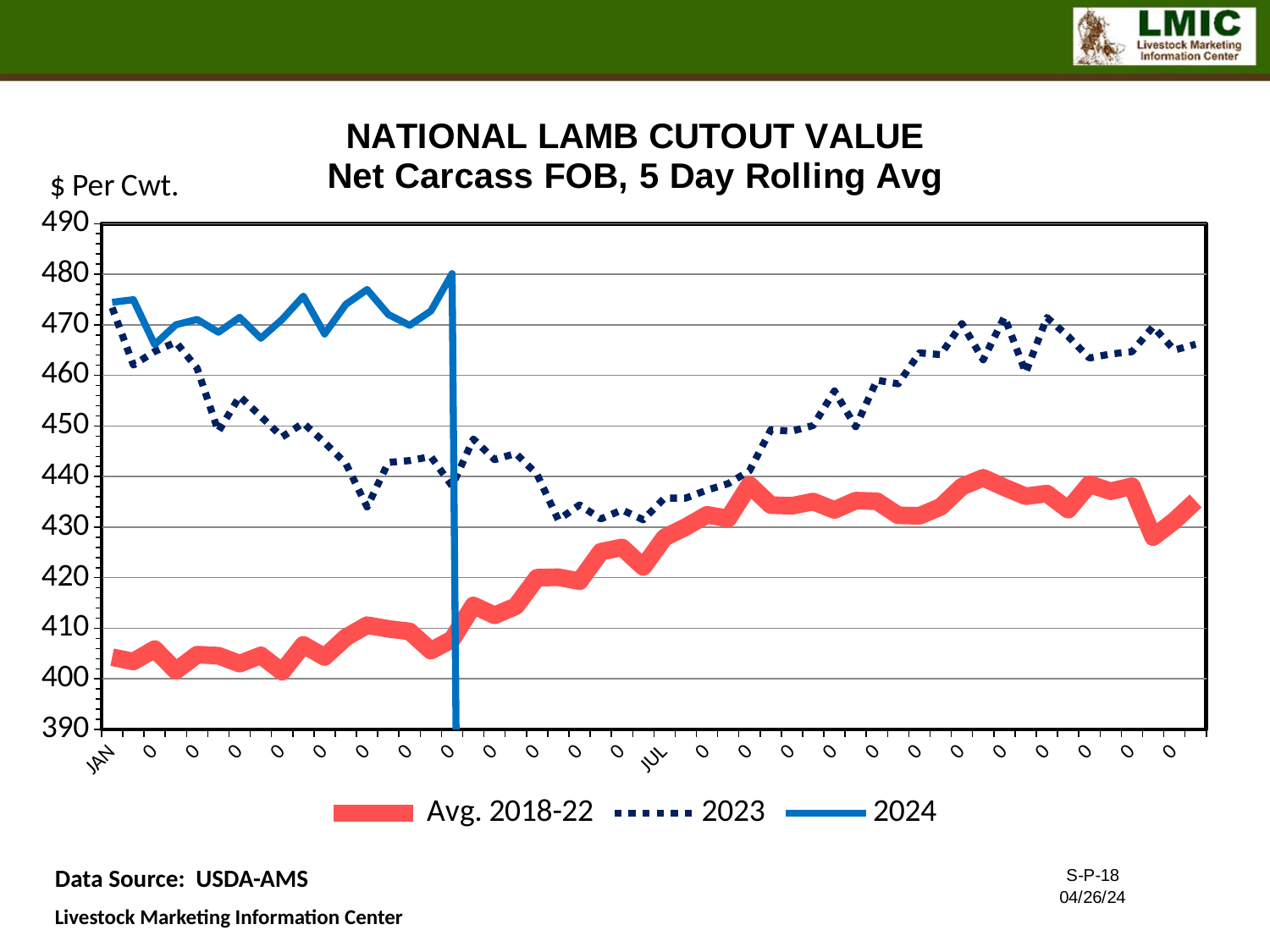
How many series does the legend list? 3 At JAN, which is higher: the 2024 series or the Avg. 2018-22 series? 2024 At JUL, which is higher: the 2023 series or the Avg. 2018-22 series? 2023 What unit is shown on the vertical axis of the chart? $ Per Cwt. Does the Avg. 2018-22 series generally rise or fall from JAN to JUL? rise Is the value of the Avg. 2018-22 series at JAN greater or less than 410? less Is the value of the 2023 series at JUL greater or less than 440? less What kind of chart is shown on the slide? line chart Which series has the lowest value at JAN? Avg. 2018-22 What are the three series listed in the legend? Avg. 2018-22, 2023, 2024 Is the value of the 2024 series at JAN greater or less than 460? greater